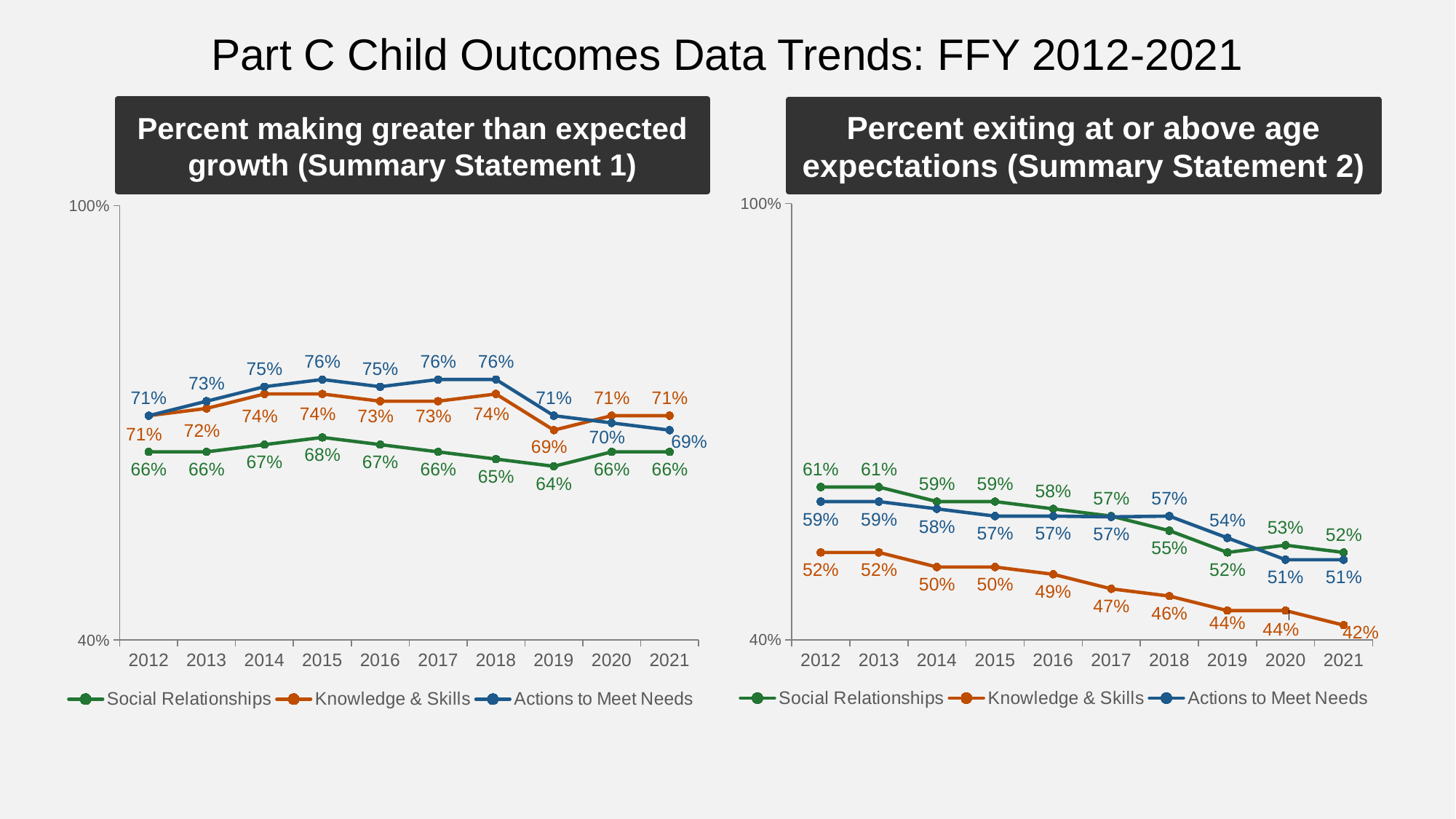
In the 'Percent making greater than expected growth (Summary Statement 1)' chart, what is the value for Social Relationships in 2019? 64% In the 'Percent making greater than expected growth (Summary Statement 1)' chart, which series has the higher value in 2021, Knowledge & Skills or Actions to Meet Needs? Knowledge & Skills In the 'Percent exiting at or above age expectations (Summary Statement 2)' chart, what is the value for Knowledge & Skills in 2021? 42% In the 'Percent making greater than expected growth (Summary Statement 1)' chart, what is the value for Actions to Meet Needs in 2015? 76% What type of chart is the 'Percent making greater than expected growth (Summary Statement 1)' chart? line chart In the 'Percent making greater than expected growth (Summary Statement 1)' chart, which year has the lowest value for Social Relationships? 2019 In the 'Percent exiting at or above age expectations (Summary Statement 2)' chart, what is the value for Social Relationships in 2012? 61% In the 'Percent exiting at or above age expectations (Summary Statement 2)' chart, what is the difference between the Social Relationships value in 2012 and in 2021? 9% In the 'Percent exiting at or above age expectations (Summary Statement 2)' chart, does the Knowledge & Skills line generally rise or fall from 2012 to 2021? fall In the 'Percent exiting at or above age expectations (Summary Statement 2)' chart, which year has the lowest value for Knowledge & Skills? 2021 How many series does the legend of the 'Percent exiting at or above age expectations (Summary Statement 2)' chart list? 3 How many years are shown on the x axis of the 'Percent making greater than expected growth (Summary Statement 1)' chart? 10